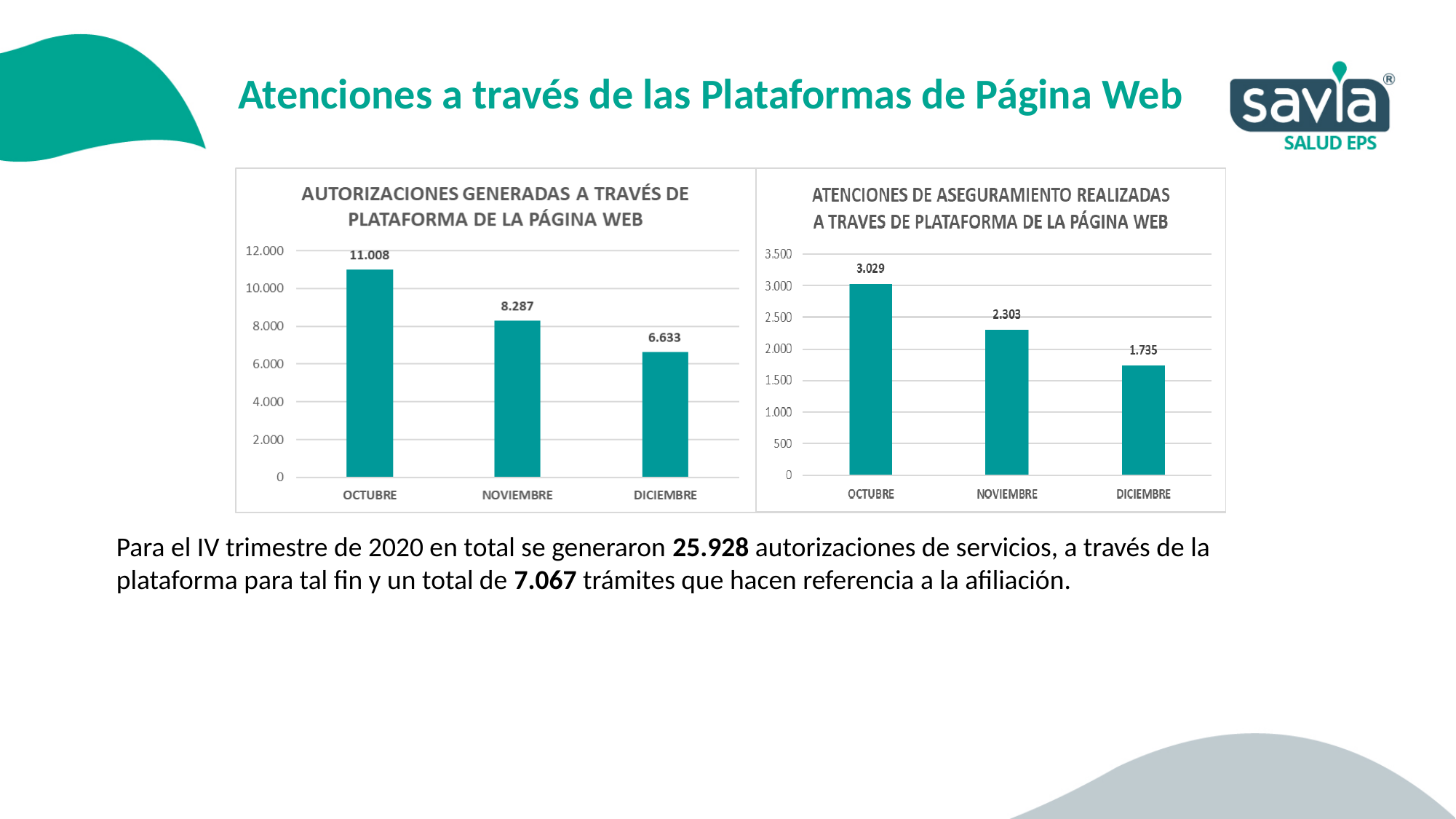
In the left chart (AUTORIZACIONES GENERADAS), what is the difference between OCTUBRE and NOVIEMBRE? 2.721 In the left chart (AUTORIZACIONES GENERADAS A TRAVÉS DE PLATAFORMA DE LA PÁGINA WEB), what is the value for OCTUBRE? 11.008 In the right chart (ATENCIONES DE ASEGURAMIENTO REALIZADAS), what is the value for NOVIEMBRE? 2.303 In the right chart (ATENCIONES DE ASEGURAMIENTO REALIZADAS), which month has the lowest value? DICIEMBRE What kind of chart is the left chart (AUTORIZACIONES GENERADAS)? Bar chart In the left chart (AUTORIZACIONES GENERADAS), what is the value for DICIEMBRE? 6.633 In the left chart (AUTORIZACIONES GENERADAS), is the value for NOVIEMBRE greater or less than 8.000? greater How many months are shown in the right chart (ATENCIONES DE ASEGURAMIENTO REALIZADAS)? 3 In the right chart (ATENCIONES DE ASEGURAMIENTO REALIZADAS), which is larger, NOVIEMBRE or DICIEMBRE? NOVIEMBRE In the right chart (ATENCIONES DE ASEGURAMIENTO REALIZADAS), what is the difference between OCTUBRE and DICIEMBRE? 1.294 In the left chart (AUTORIZACIONES GENERADAS), which month has the highest value? OCTUBRE In the right chart (ATENCIONES DE ASEGURAMIENTO REALIZADAS), do the values rise or fall from OCTUBRE to DICIEMBRE? Fall